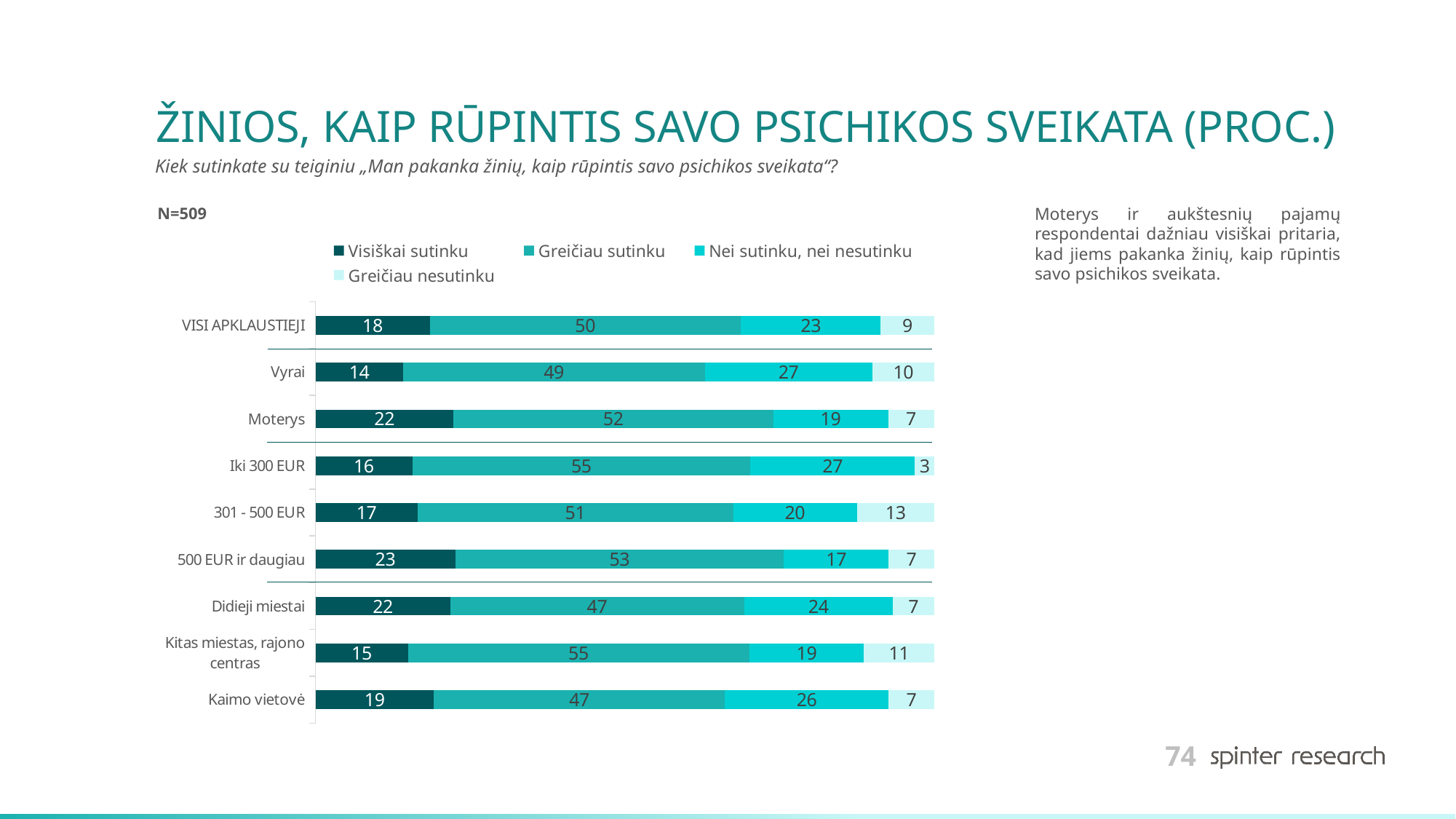
Which is larger: the "Greičiau nesutinku" value for 301 - 500 EUR or for Kitas miestas, rajono centras? 301 - 500 EUR Which category has the lowest value for "Greičiau nesutinku"? Iki 300 EUR What is the total of the stacked bar for Kaimo vietovė? 99 What is the difference between the "Visiškai sutinku" values for Moterys and Vyrai? 8 What is the value of "Nei sutinku, nei nesutinku" for Vyrai? 27 How many categories (bars) are shown in the chart? 9 What is the sample size (N) shown on the slide? N=509 Which category has the highest value for "Visiškai sutinku"? 500 EUR ir daugiau What is the value of "Visiškai sutinku" for Moterys? 22 How many series does the legend list? 4 What type of chart is shown on the slide? Stacked bar chart What is the value of "Greičiau sutinku" for Iki 300 EUR? 55